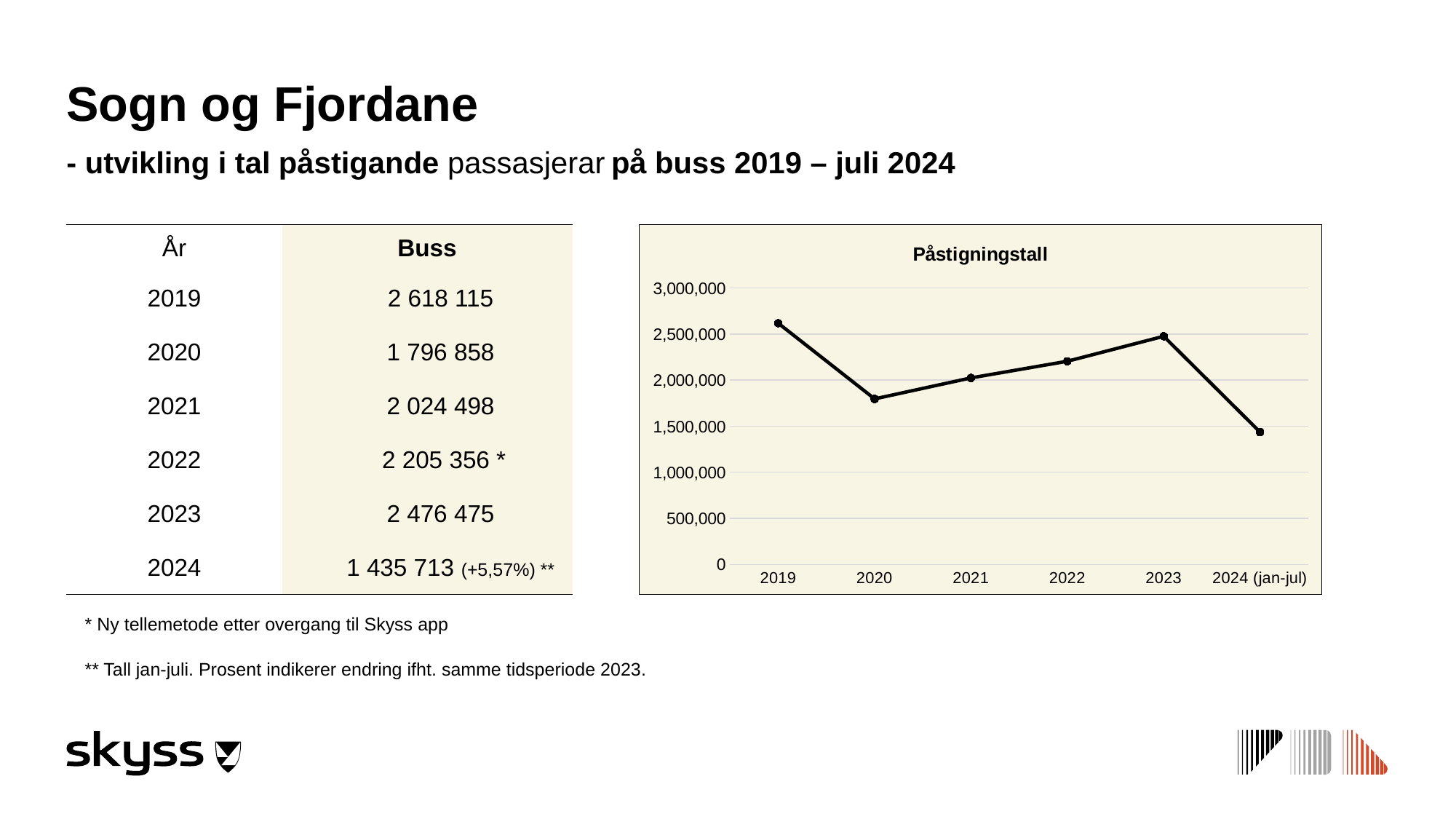
Which is larger, the value for 2022 or the value for 2023? 2023 What kind of chart is shown on the slide? line chart What is the value for 2019? 2 618 115 What is the title of the chart? Påstigningstall Is the value for 2020 greater or less than 2,000,000? less How many data points are plotted on the chart? 6 What is the value for 2023? 2 476 475 Which year has the highest value on the chart? 2019 Is the value for 2019 greater or less than 2,500,000? greater Do the values rise or fall from 2020 to 2023? rise What is the value for 2024 (jan-jul)? 1 435 713 Which point on the chart has the lowest value? 2024 (jan-jul)